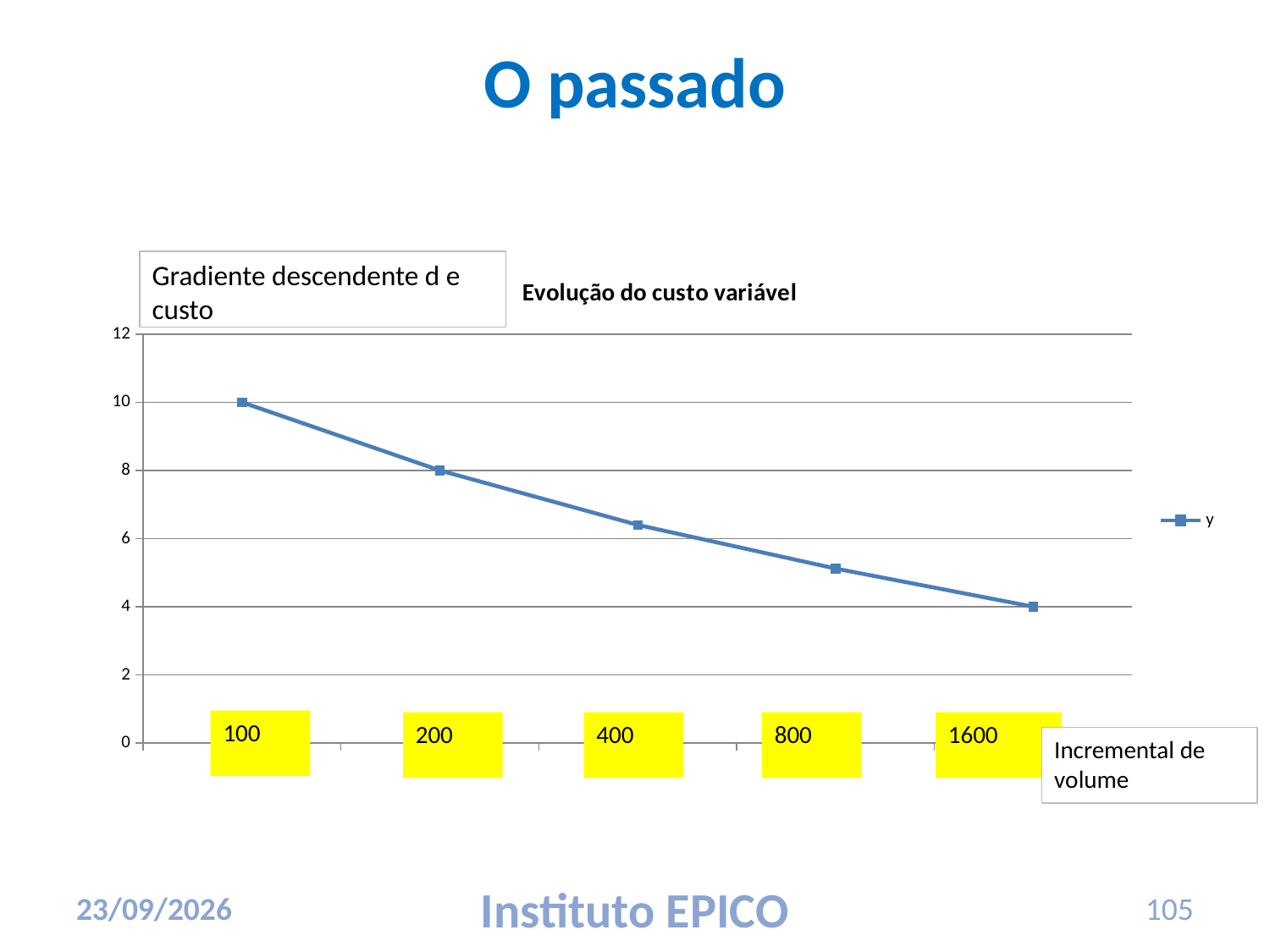
What is the value of y at volume 200? 8 What is the title of the chart? Evolução do custo variável What is the name of the series shown in the legend? y Is the value for volume 400 greater or less than 6? greater Do the values rise or fall as volume increases along the x axis? fall How many series does the legend list? 1 At which volume is the value of y highest? 100 What is the value of y at volume 100? 10 How many data points are plotted on the line? 5 At which volume is the value of y lowest? 1600 What kind of chart is shown on the slide? line chart What is the value of y at volume 1600? 4